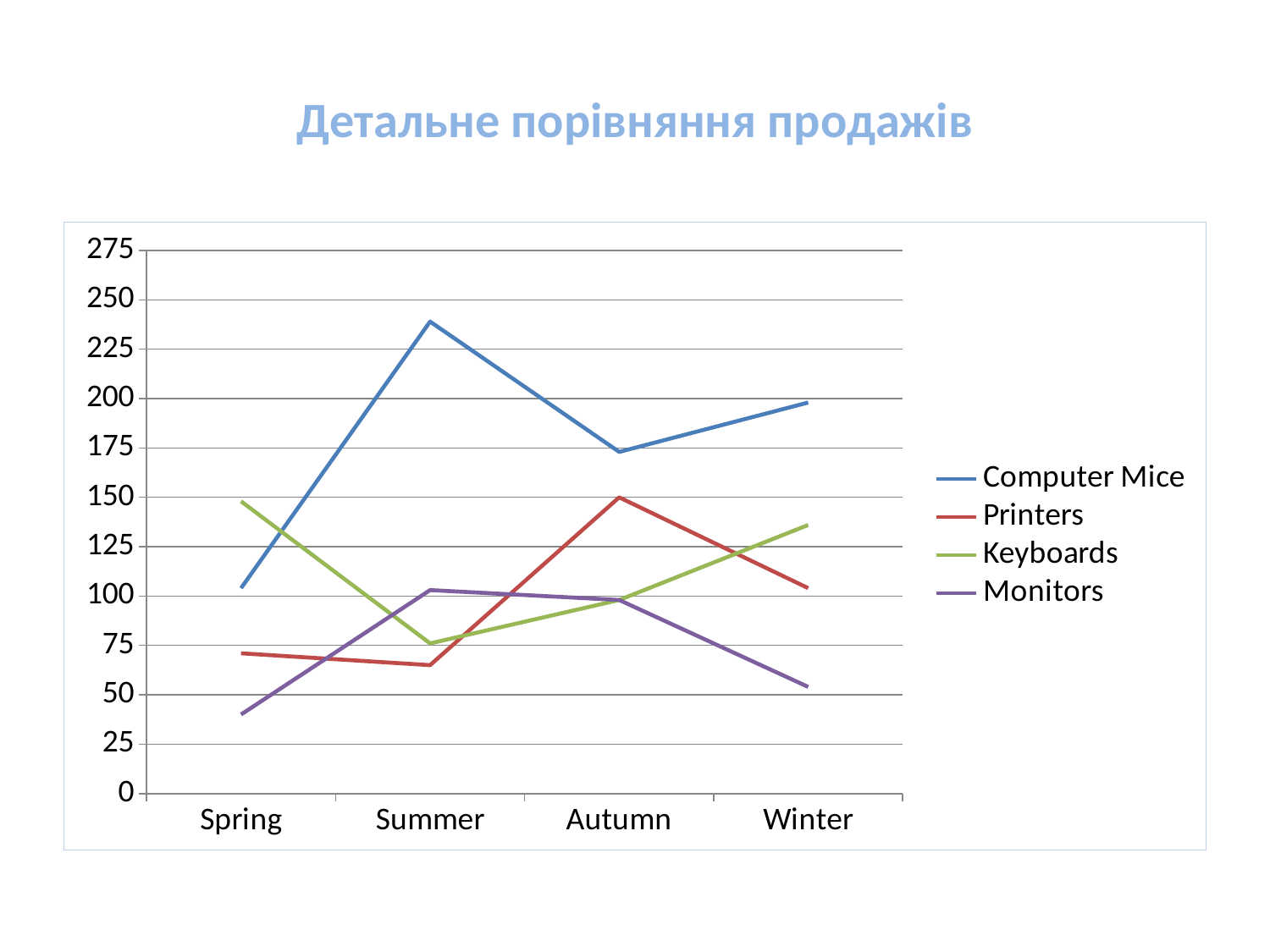
Is the value for Printers in Summer greater or less than 75? less How many series does the legend list? 4 What is the title of the slide? Детальне порівняння продажів Is the value for Keyboards in Spring greater or less than 125? greater Is the value for Computer Mice in Summer greater or less than 225? greater How many categories are shown on the x axis? 4 In which season is the value for Monitors lowest? Spring What kind of chart is shown on the slide? line chart In which season is the value for Computer Mice highest? Summer In Spring, which is larger: Keyboards or Printers? Keyboards Does the value for Monitors rise or fall from Autumn to Winter? fall